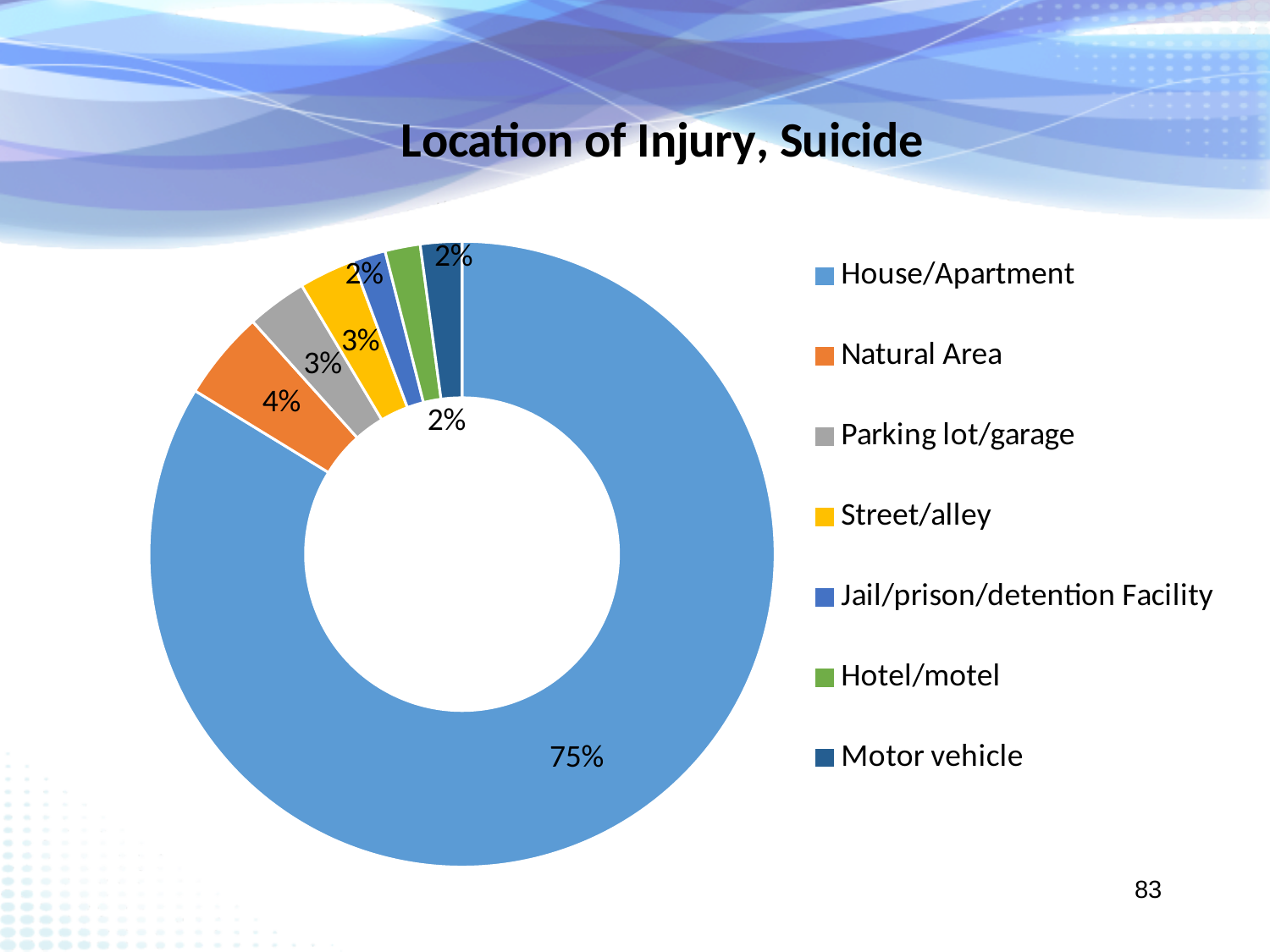
Which is larger, the share for Natural Area or the share for Hotel/motel? Natural Area What is the difference in percentage points between House/Apartment and Natural Area? 71 percentage points What is the title of the chart? Location of Injury, Suicide What percentage is shown for Motor vehicle? 2% How many categories does the legend list? 7 Which location has the largest share of the chart? House/Apartment What percentage is shown for Natural Area? 4% What percentage is shown for Parking lot/garage? 3% What type of chart is shown on the slide? Doughnut (pie) chart What percentage is shown for Street/alley? 3% What percentage of the chart is House/Apartment? 75% What colour represents Street/alley in the chart? Yellow